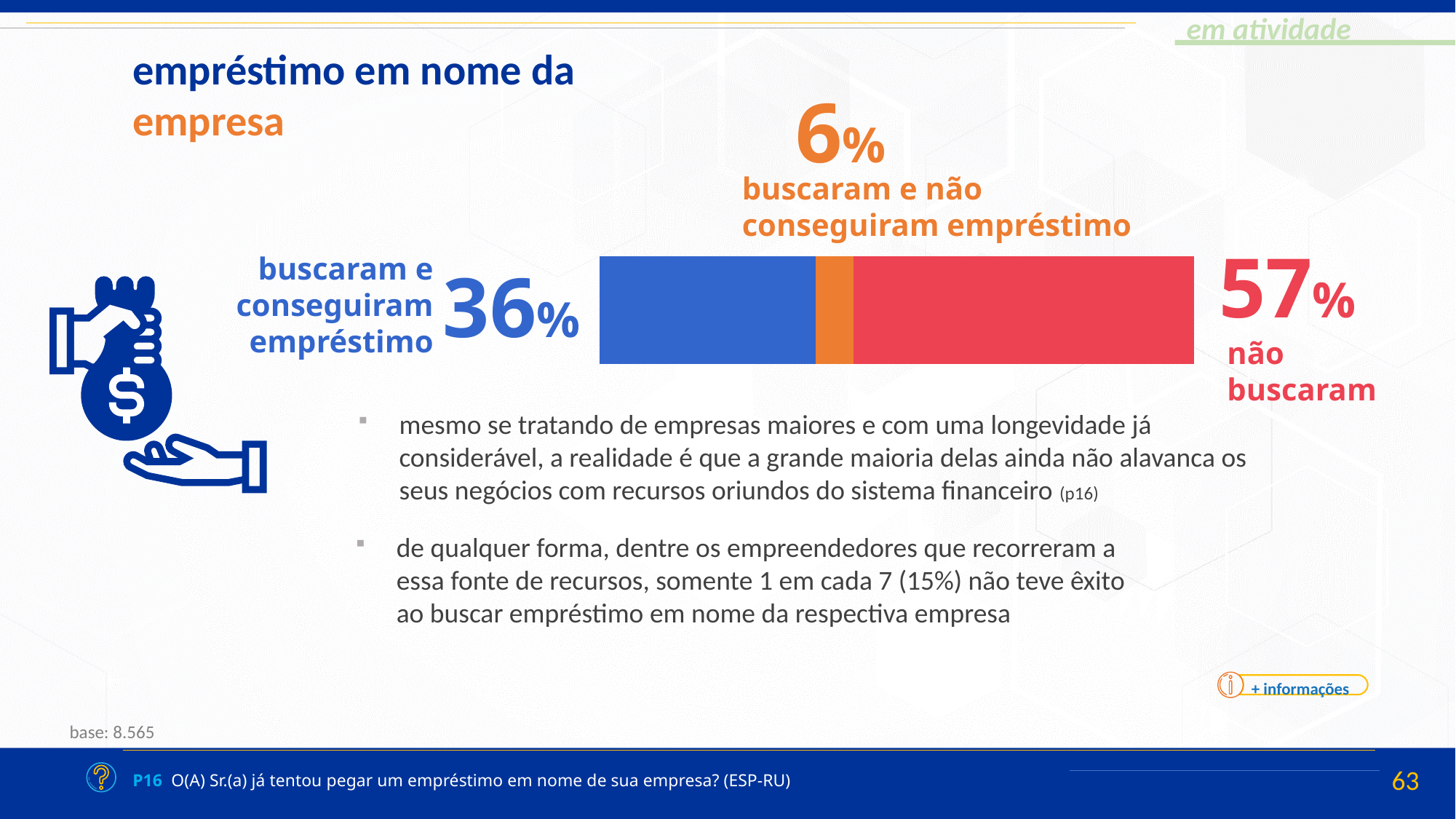
What is the base (sample size) shown for the chart? 8.565 Which category has the smallest share of the bar? buscaram e não conseguiram empréstimo What kind of chart is shown on the slide? stacked bar chart Which is larger: the share that sought and obtained a loan, or the share that did not seek a loan? não buscaram Which category has the largest share of the bar? não buscaram What percentage of companies sought and obtained a loan (buscaram e conseguiram empréstimo)? 36% How many segments does the stacked bar have? 3 What colour is the segment representing 'não buscaram'? red What is the difference in percentage points between 'buscaram e conseguiram empréstimo' and 'buscaram e não conseguiram empréstimo'? 30 What is the difference in percentage points between 'não buscaram' and 'buscaram e conseguiram empréstimo'? 21 What percentage of companies did not seek a loan (não buscaram)? 57% What percentage of companies sought but did not obtain a loan (buscaram e não conseguiram empréstimo)? 6%